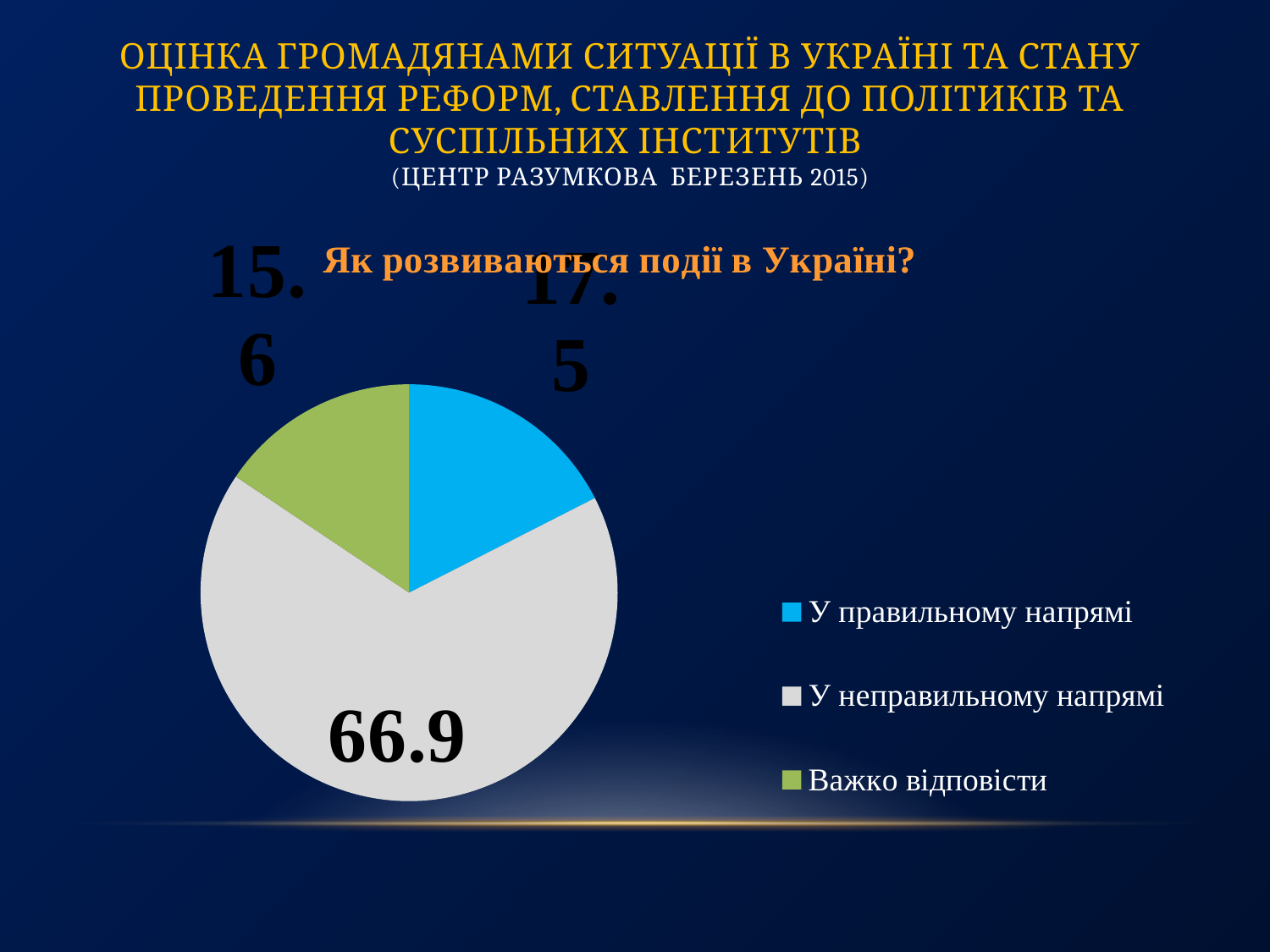
How many entries does the legend of the pie chart list? 3 What is the value for "У неправильному напрямі" in the pie chart? 66.9 What kind of chart is shown on the slide? pie chart What is the value for "У правильному напрямі" in the pie chart? 17.5 Which is larger in the pie chart: "У правильному напрямі" or "У неправильному напрямі"? У неправильному напрямі How many slices does the pie chart have? 3 What colour is the slice for "Важко відповісти" in the pie chart? green Which category has the largest slice in the pie chart? У неправильному напрямі What is the value for "Важко відповісти" in the pie chart? 15.6 What is the title of the pie chart? Як розвиваються події в Україні? Which category has the smallest slice in the pie chart? Важко відповісти What is the difference between the values for "У неправильному напрямі" and "Важко відповісти"? 51.3